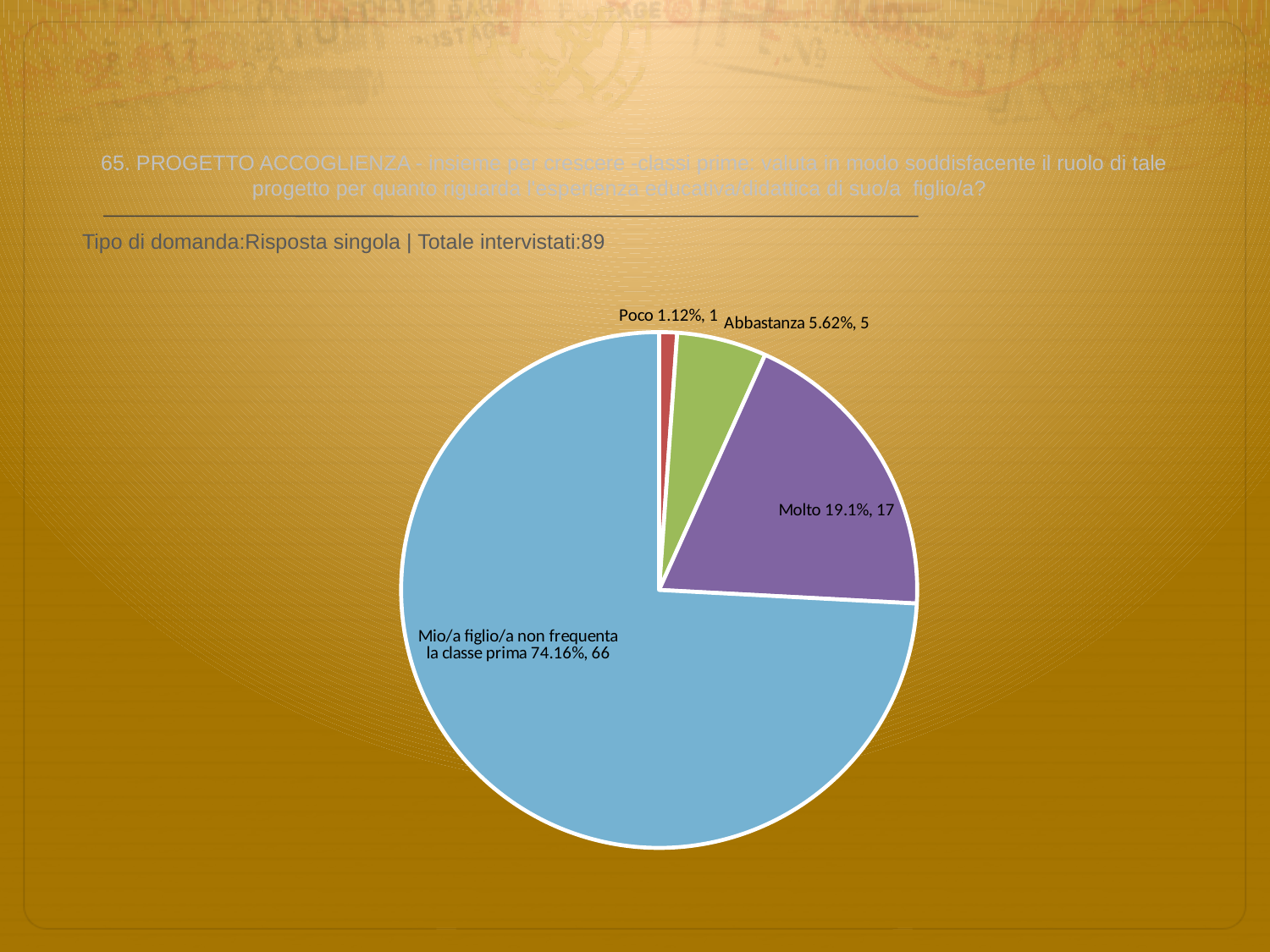
How many respondents answered 'Poco'? 1 How many respondents answered 'Abbastanza'? 5 What percentage share does the 'Mio/a figlio/a non frequenta la classe prima' slice have? 74.16% Which is larger, the 'Abbastanza' slice or the 'Molto' slice? Molto What kind of chart is shown on the slide? pie chart What percentage share does the 'Molto' slice have? 19.1% What colour is the 'Molto' slice? purple What is the difference in count between 'Molto' and 'Abbastanza'? 12 What is the total number of respondents shown on the slide? 89 Which category has the largest slice? Mio/a figlio/a non frequenta la classe prima How many slices does the pie chart have? 4 Which category has the smallest slice? Poco